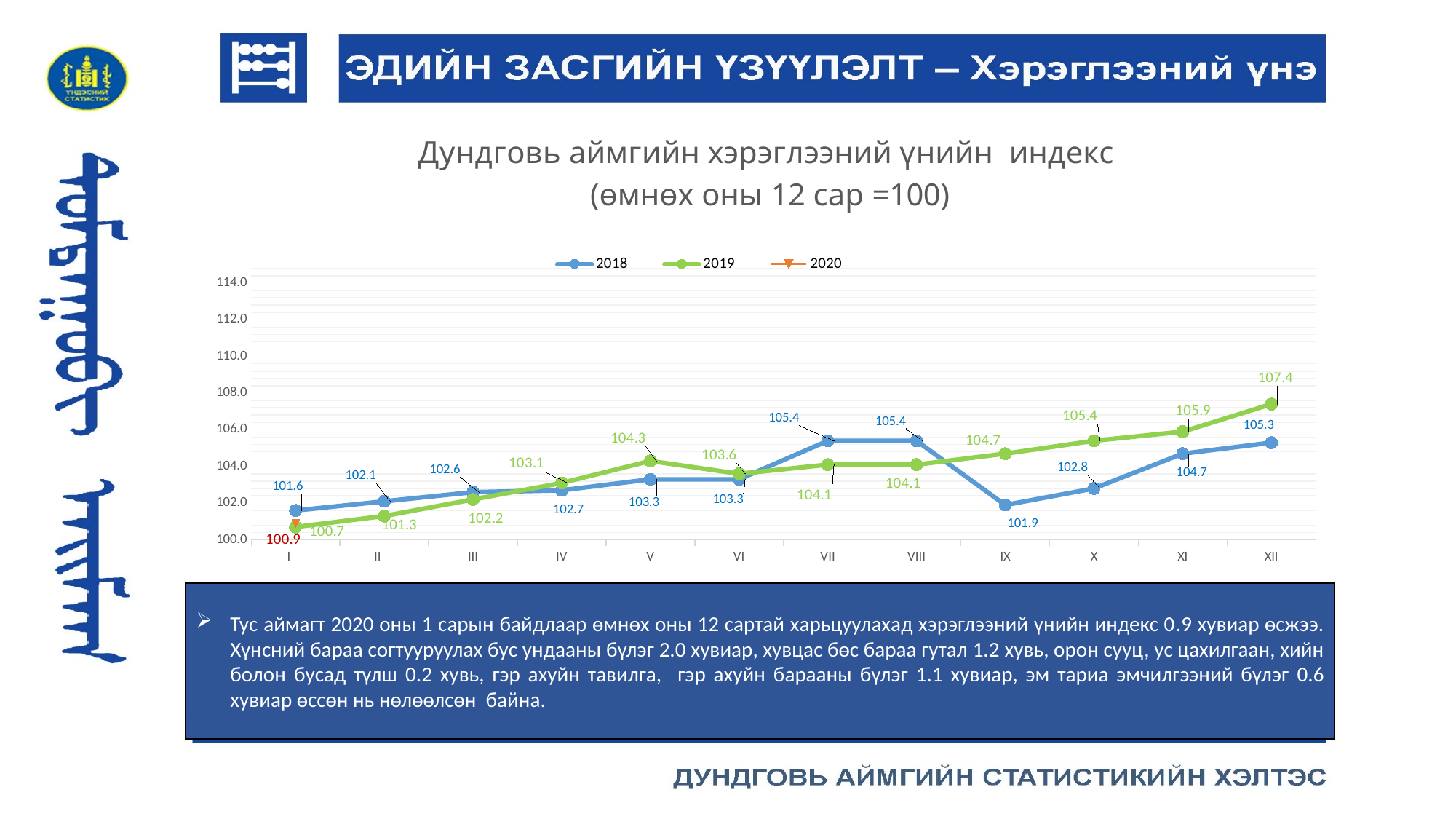
How many months are shown on the x axis? 12 In which month is the 2019 series lowest? I Does the 2019 series generally rise or fall from month I to month XII? rise How many series does the legend list? 3 What kind of chart is shown on the slide? line chart Which is larger in month VII, the 2018 value or the 2019 value? 2018 In which month is the 2019 series highest? XII What is the title of the chart? Дундговь аймгийн хэрэглээний үнийн индекс (өмнөх оны 12 сар =100) What is the value for 2019 in month XII? 107.4 What is the difference between the 2019 and 2018 values in month XII? 2.1 What is the value for 2018 in month IX? 101.9 What is the value for 2020 in month I? 100.9